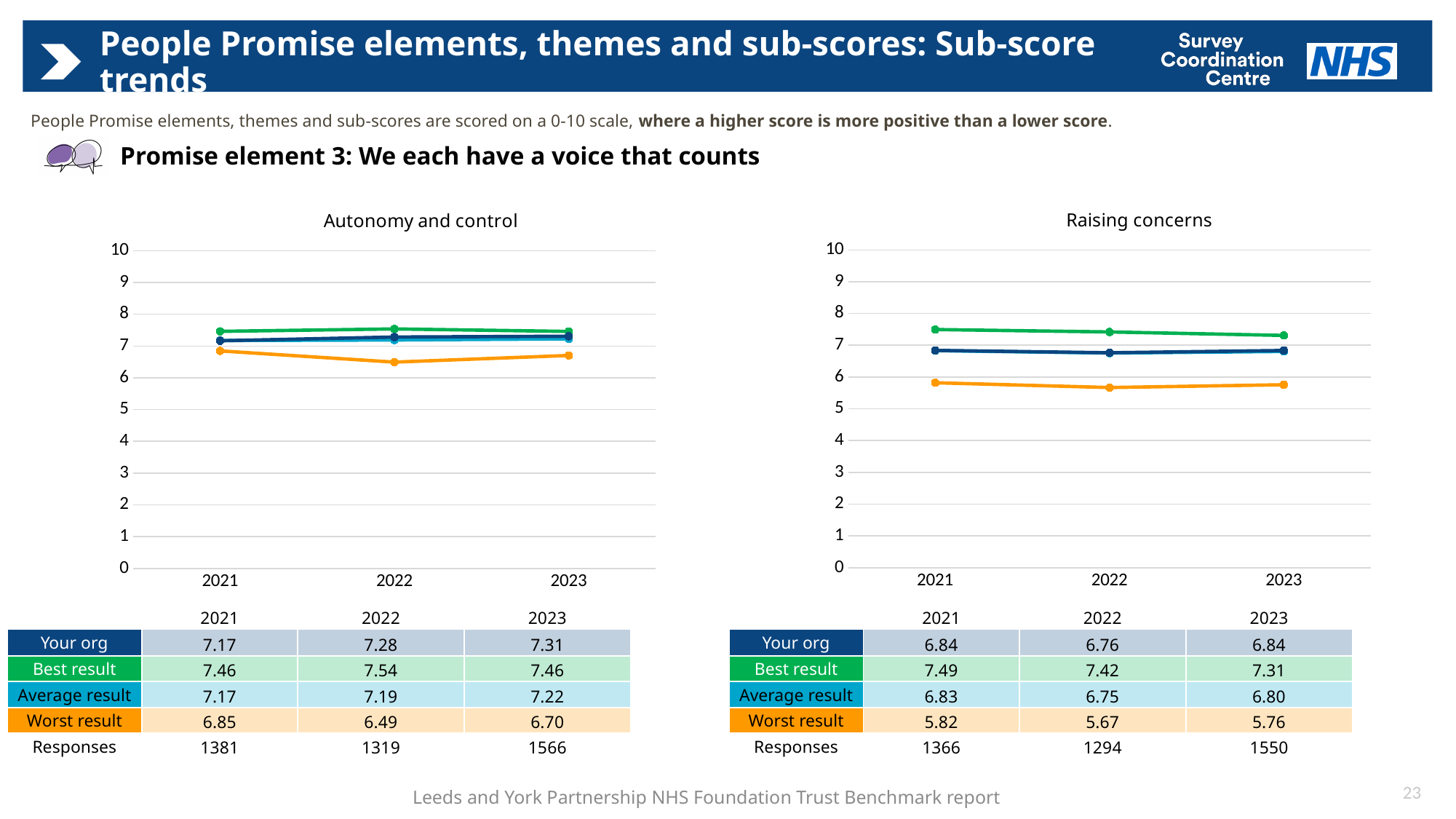
In the 'Autonomy and control' chart, which year has the highest 'Best result' value? 2022 In the 'Autonomy and control' chart, does the 'Your org' line rise or fall from 2021 to 2023? rise In the 'Raising concerns' chart, which year has the lowest 'Your org' value? 2022 In the 'Raising concerns' chart, what is the 'Worst result' value for 2022? 5.67 In the 'Autonomy and control' chart, what is the 'Your org' value for 2023? 7.31 What type of chart is the 'Autonomy and control' chart? line chart In the 'Autonomy and control' chart, what is the difference between the 'Best result' and 'Worst result' values in 2022? 1.05 How many series are plotted in the 'Raising concerns' chart? 4 In the 'Raising concerns' chart, is the 'Worst result' value for 2021 greater or less than 6? less In the 'Raising concerns' chart, is the 'Your org' value in 2023 larger or smaller than the 'Average result' value in 2023? larger How many years are shown on the x axis of the 'Autonomy and control' chart? 3 In the 'Raising concerns' chart, how many responses were recorded in 2023? 1550